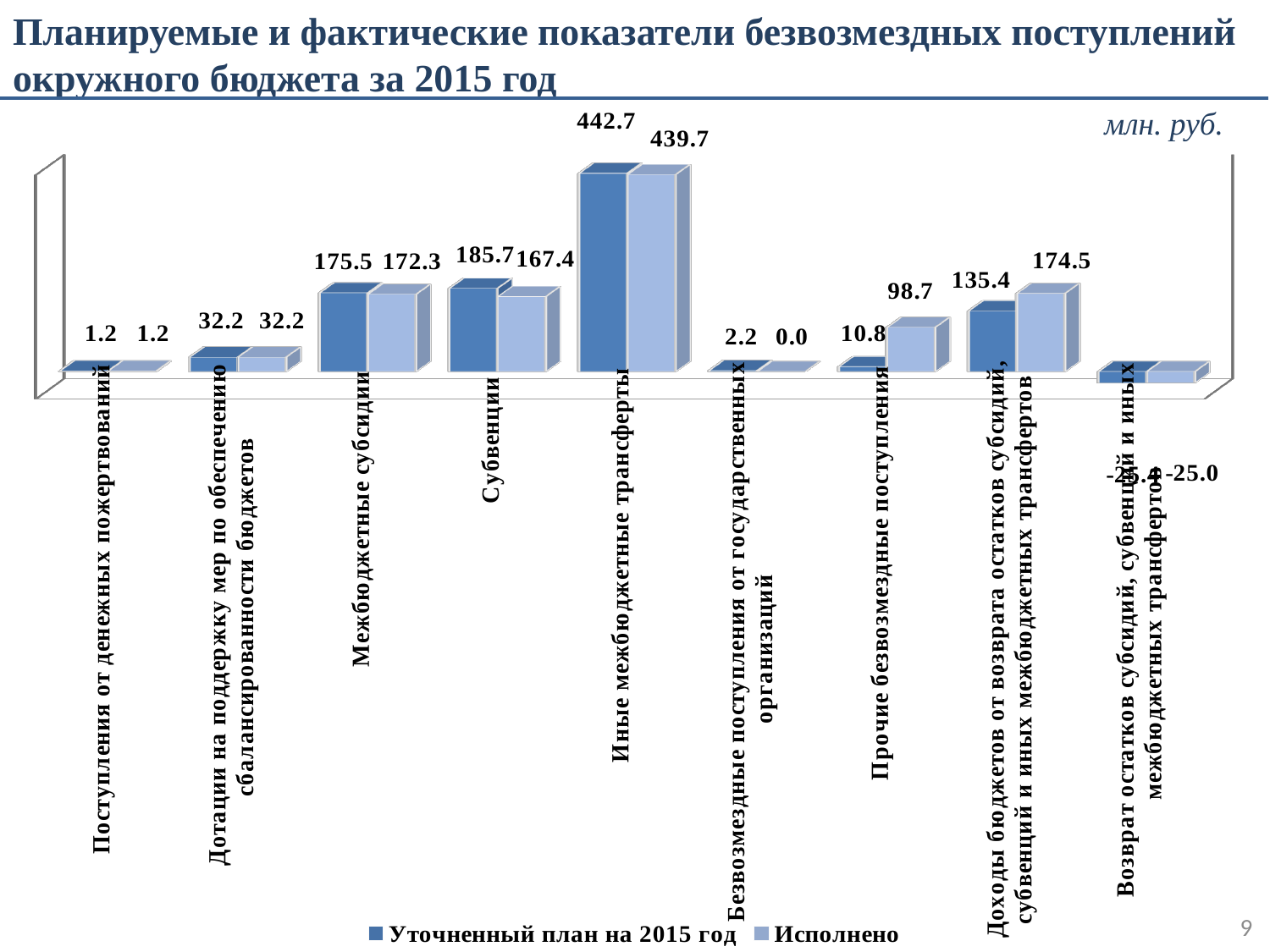
How many series does the legend list? 2 How many categories are shown on the x axis of the chart? 9 What unit of measurement is indicated on the chart? млн. руб. What is the value of 'Исполнено' for 'Субвенции'? 167.4 What is the value of 'Уточненный план на 2015 год' for 'Безвозмездные поступления от государственных организаций'? 2.2 Which category has the highest value for 'Исполнено'? Иные межбюджетные трансферты What type of chart is shown on the slide? Bar chart What is the value of 'Уточненный план на 2015 год' for 'Иные межбюджетные трансферты'? 442.7 Which is larger for 'Межбюджетные субсидии': 'Уточненный план на 2015 год' or 'Исполнено'? Уточненный план на 2015 год What is the difference between 'Уточненный план на 2015 год' and 'Исполнено' for 'Субвенции'? 18.3 What is the difference between 'Исполнено' and 'Уточненный план на 2015 год' for 'Доходы бюджетов от возврата остатков субсидий, субвенций и иных межбюджетных трансфертов'? 39.1 What is the value of 'Исполнено' for 'Прочие безвозмездные поступления'? 98.7